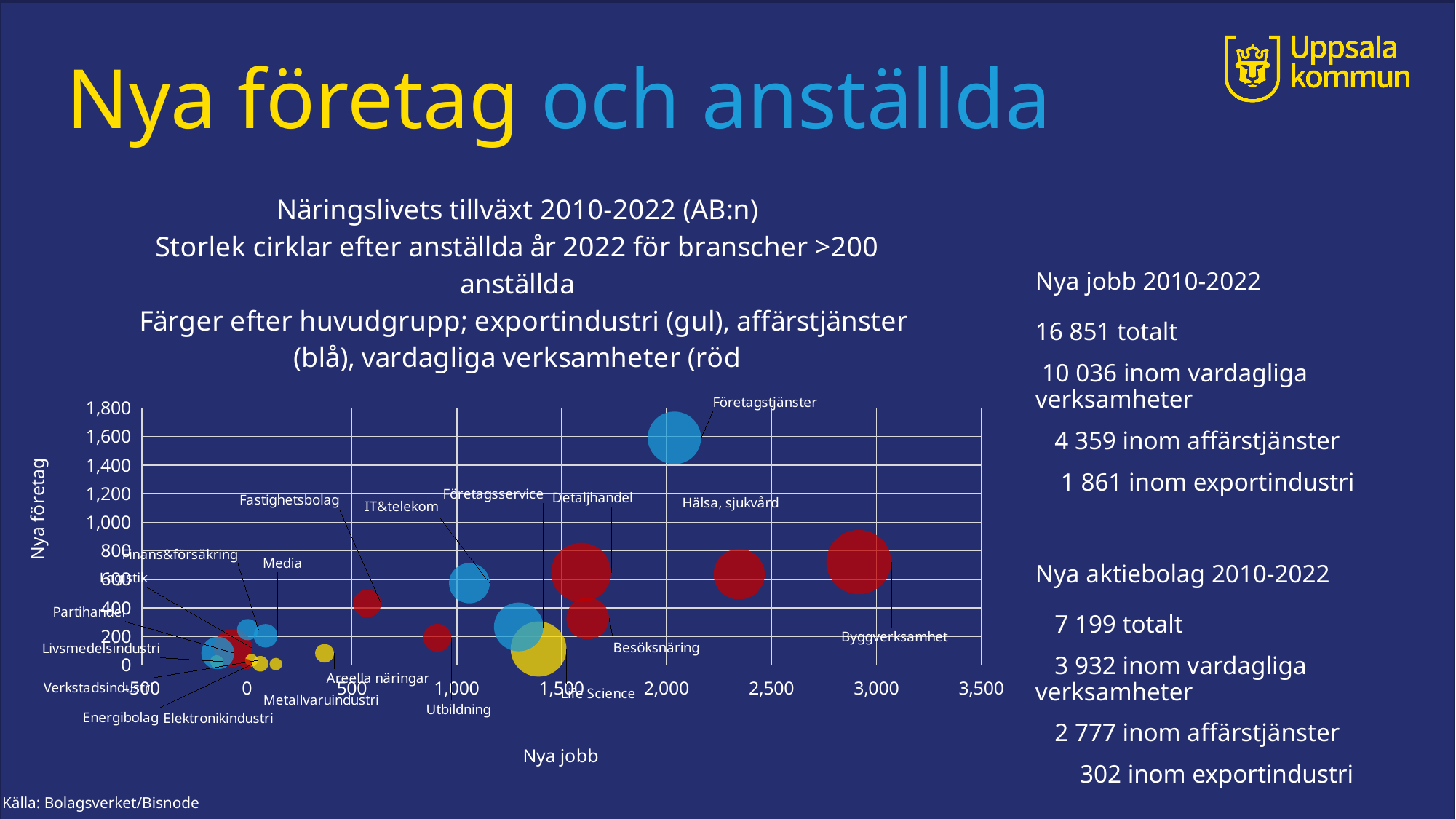
Is the number of new companies (Nya företag) for Hälsa, sjukvård greater or less than 1,000? less What kind of chart is shown on the slide? bubble chart Is the number of new companies (Nya företag) for IT&telekom greater or less than 800? less Is the number of new jobs (Nya jobb) for Företagstjänster greater or less than 2,500? less What is the title of the x axis of the chart? Nya jobb What is the title of the y axis of the chart? Nya företag Which industry is plotted furthest to the right, i.e. has the most new jobs (Nya jobb)? Byggverksamhet Which industry has the highest number of new companies (Nya företag) in the chart? Företagstjänster Which has more new jobs (Nya jobb): Byggverksamhet or Detaljhandel? Byggverksamhet Which has more new companies (Nya företag): Företagstjänster or Hälsa, sjukvård? Företagstjänster